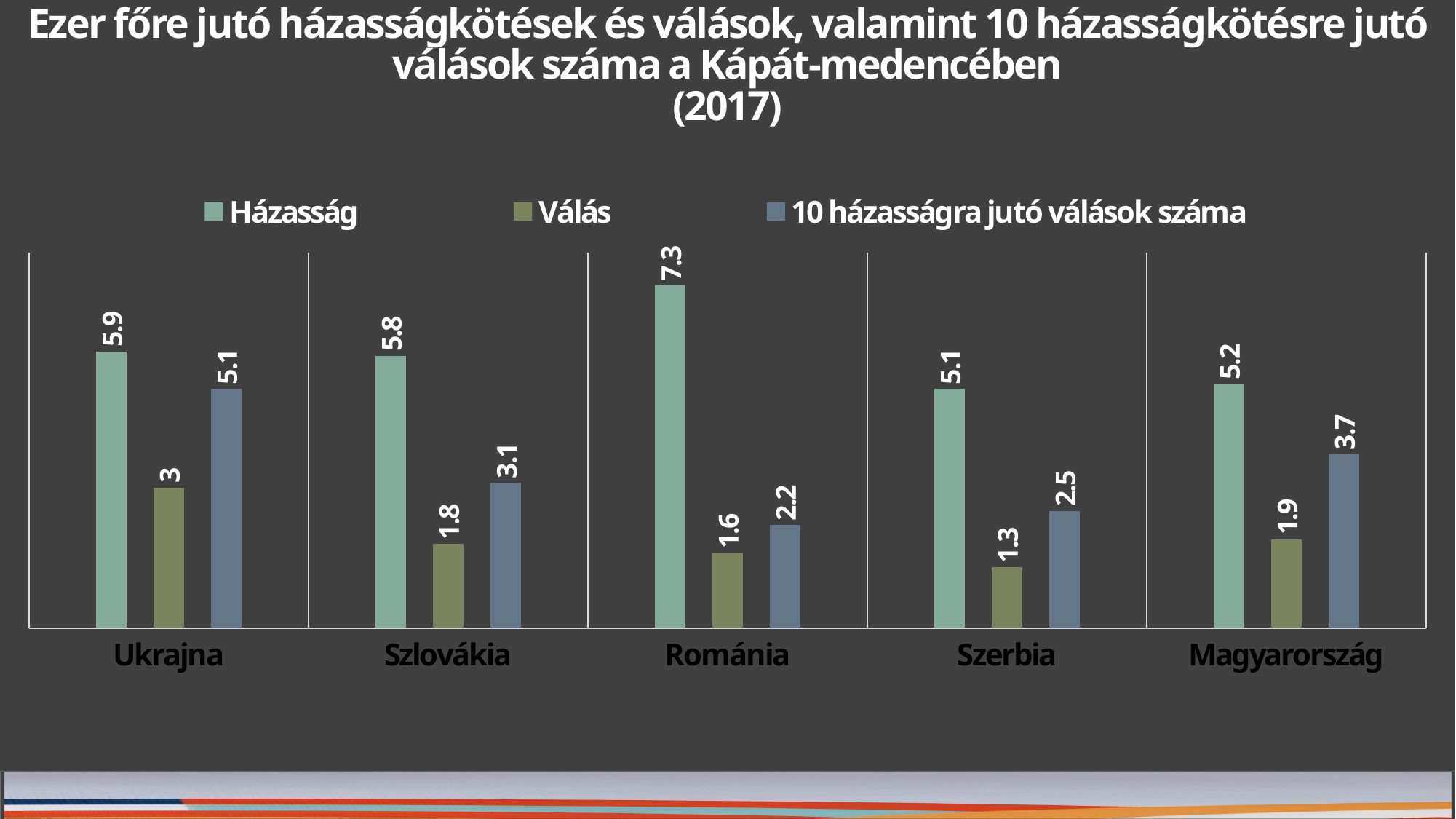
What is the difference between the Házasság value for Románia and the Házasság value for Szerbia? 2.2 Which country has the highest Házasság value? Románia Which country has the highest '10 házasságra jutó válások száma' value? Ukrajna Which country has the lowest Válás value? Szerbia What year is given in the chart title? 2017 What is the Válás value for Ukrajna? 3 Which is larger: the '10 házasságra jutó válások száma' value for Ukrajna or for Szlovákia? Ukrajna How many series does the legend list? 3 How many countries are shown on the x axis? 5 What is the Házasság value for Románia? 7.3 What kind of chart is shown on the slide? Bar chart What is the value of '10 házasságra jutó válások száma' for Magyarország? 3.7